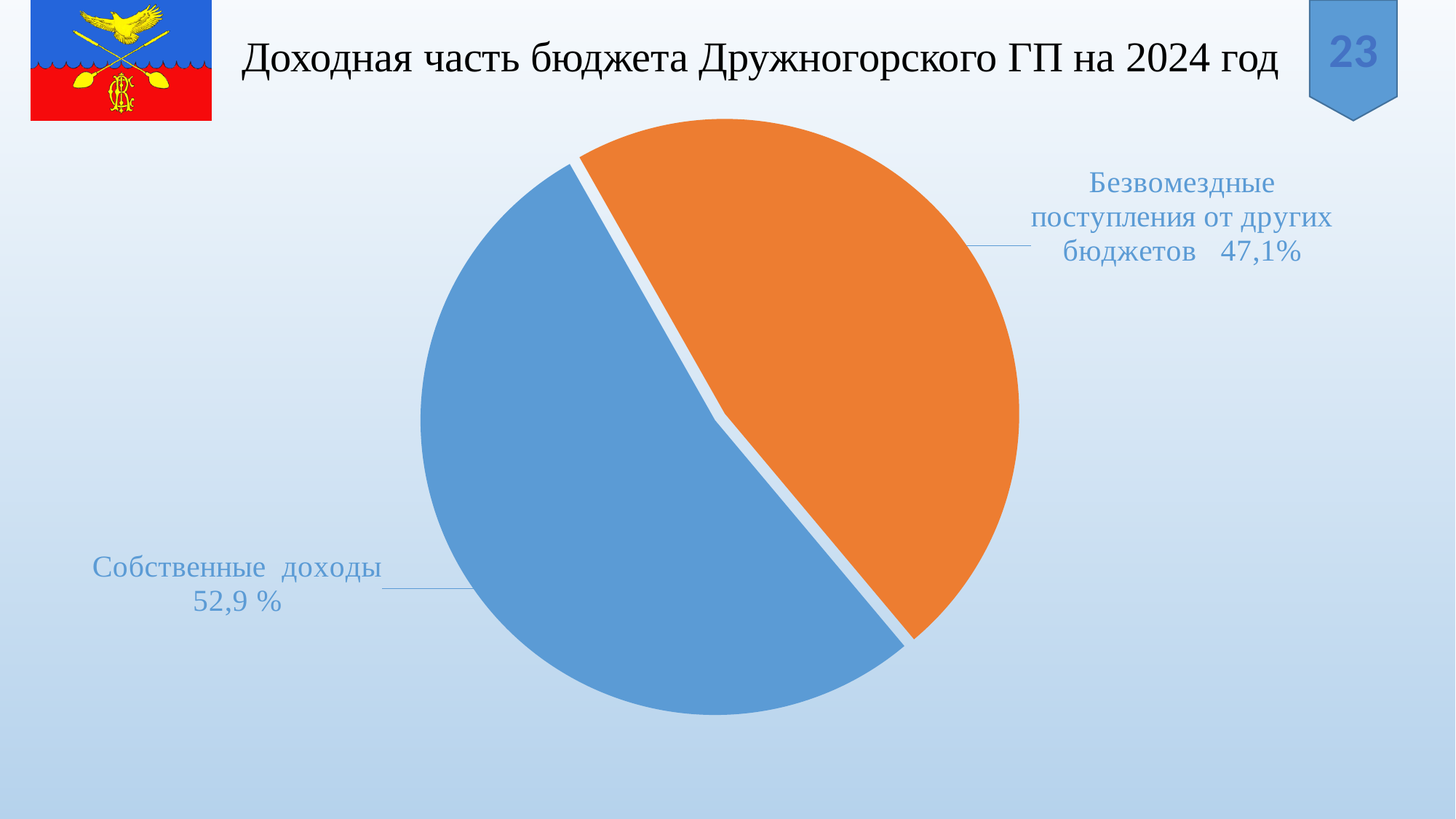
Which is larger: the share for "Собственные доходы" or the share for "Безвомездные поступления от других бюджетов"? Собственные доходы Which slice of the pie is the largest? Собственные доходы What share of the pie is labelled "Безвомездные поступления от других бюджетов"? 47,1% What is the difference in percentage points between the "Собственные доходы" share and the "Безвомездные поступления от других бюджетов" share? 5,8 What kind of chart is shown on the slide? pie chart What colour is the slice for "Собственные доходы"? blue Which slice of the pie is the smallest? Безвомездные поступления от других бюджетов What share of the pie is labelled "Собственные доходы"? 52,9 % What is the title of the slide containing the pie chart? Доходная часть бюджета Дружногорского ГП на 2024 год How many slices does the pie chart have? 2